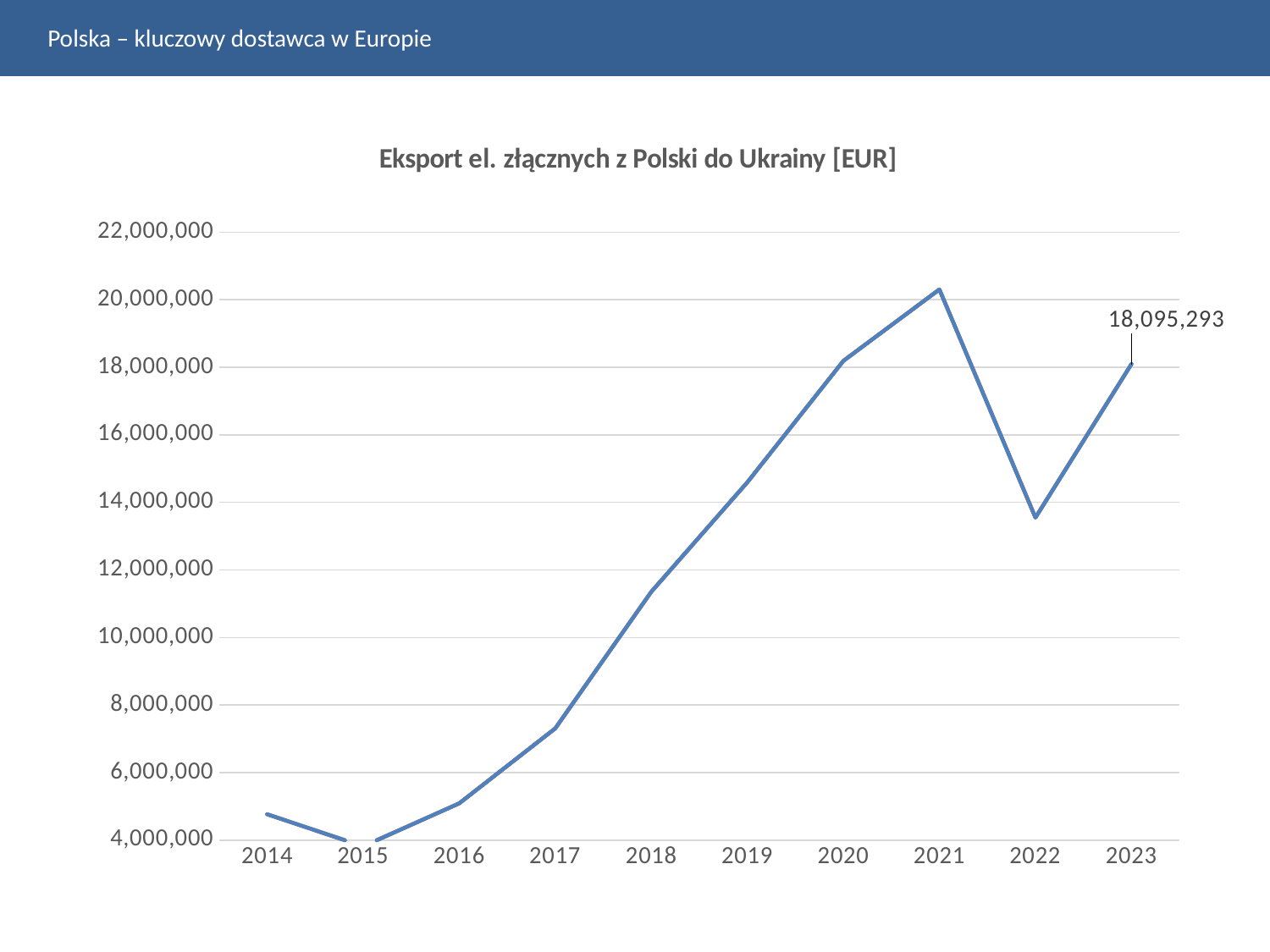
Which is larger, the value for 2019 or the value for 2022? 2019 Is the value for 2022 greater or less than 14,000,000? less Which is larger, the value for 2016 or the value for 2018? 2018 Which year has the highest value? 2021 Is the value for 2020 greater or less than 18,000,000? greater Is the value for 2017 greater or less than 8,000,000? less Which year has the lowest value? 2015 What kind of chart is shown? Line chart How many years are plotted on the x axis? 10 What is the value for 2023? 18,095,293 What is the title of the chart? Eksport el. złącznych z Polski do Ukrainy [EUR]